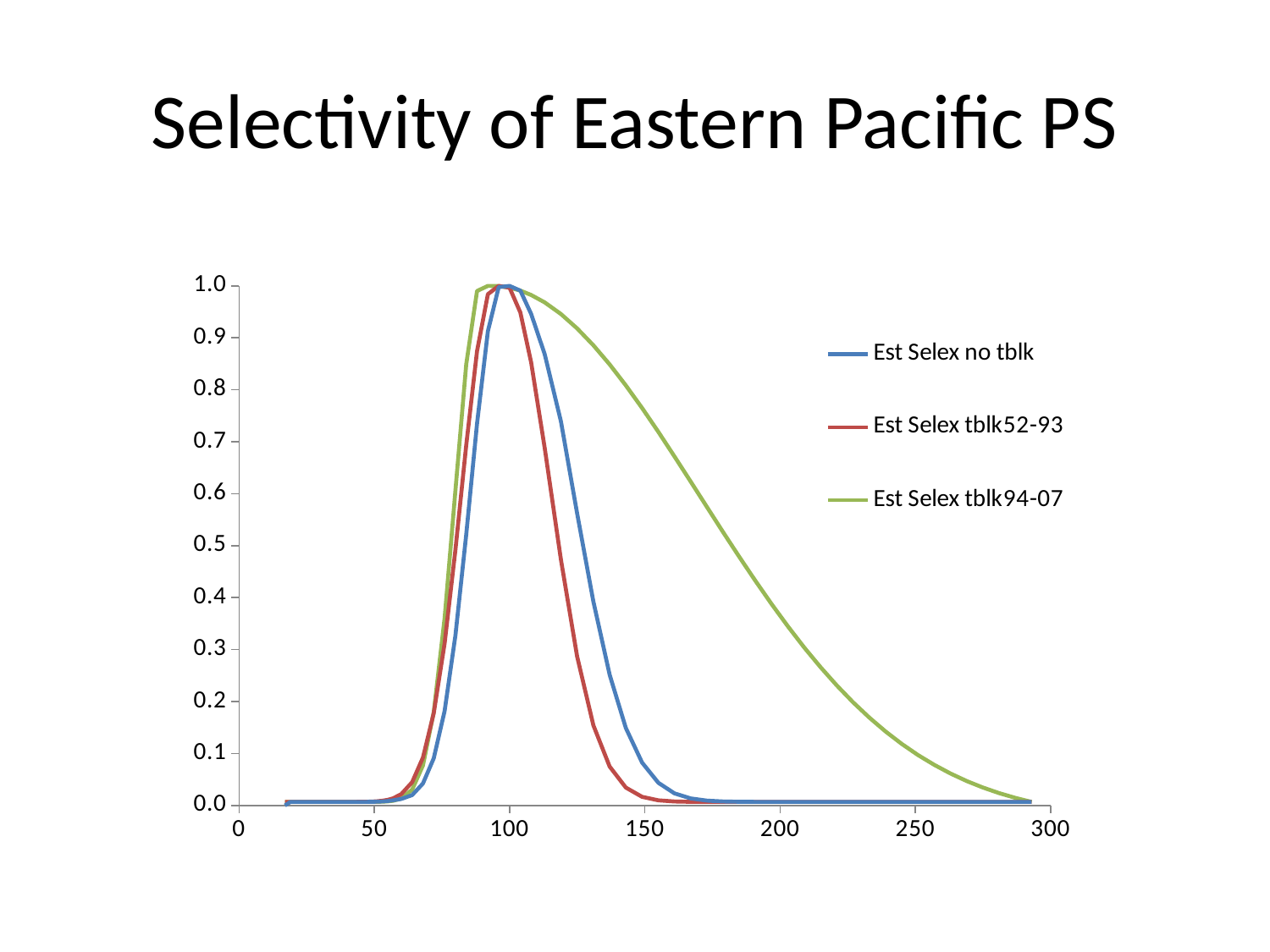
What kind of chart is shown on the slide? line chart At x = 150, is the value for Est Selex tblk52-93 greater or less than 0.1? less How many series does the legend list? 3 At x = 200, is the value for Est Selex tblk94-07 greater or less than 0.5? less Between x = 100 and x = 300, does the Est Selex tblk94-07 line rise or fall? fall Which series is drawn in green? Est Selex tblk94-07 What is the title of the slide's chart? Selectivity of Eastern Pacific PS Which series extends furthest to the right along the x axis before reaching zero? Est Selex tblk94-07 At x = 150, which series has the larger value, Est Selex tblk94-07 or Est Selex no tblk? Est Selex tblk94-07 At x = 150, is the value for Est Selex no tblk greater or less than 0.2? less What is the maximum value reached by the lines on the y axis? 1.0